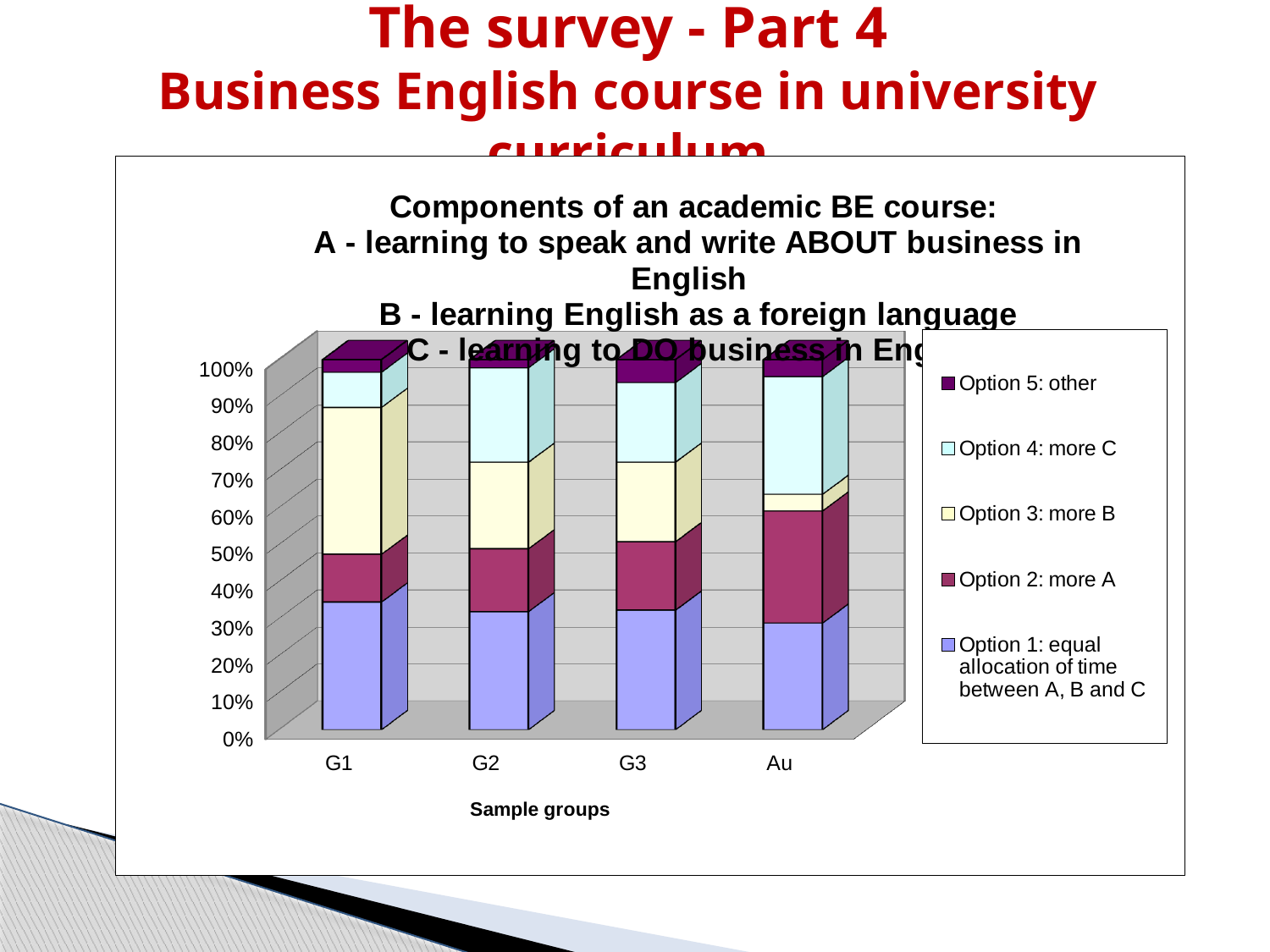
Is the Option 1 (equal allocation) share for G1 greater or less than 40%? less How many series does the chart's legend list? 5 Which sample group has the largest Option 3 (more B) segment? G1 Which sample group has the largest Option 4 (more C) segment? Au What kind of chart is shown on the slide? Stacked bar chart According to the legend, what does Option 4 stand for? more C Is the Option 3 (more B) share for Au greater or less than 10%? less What is the title of the x axis of the chart? Sample groups Is the Option 3 (more B) share for G1 greater or less than 30%? greater Is the Option 2 (more A) segment larger for G1 or for Au? Au How many sample groups are shown on the x axis of the chart? 4 Which sample group has the smallest Option 3 (more B) segment? Au